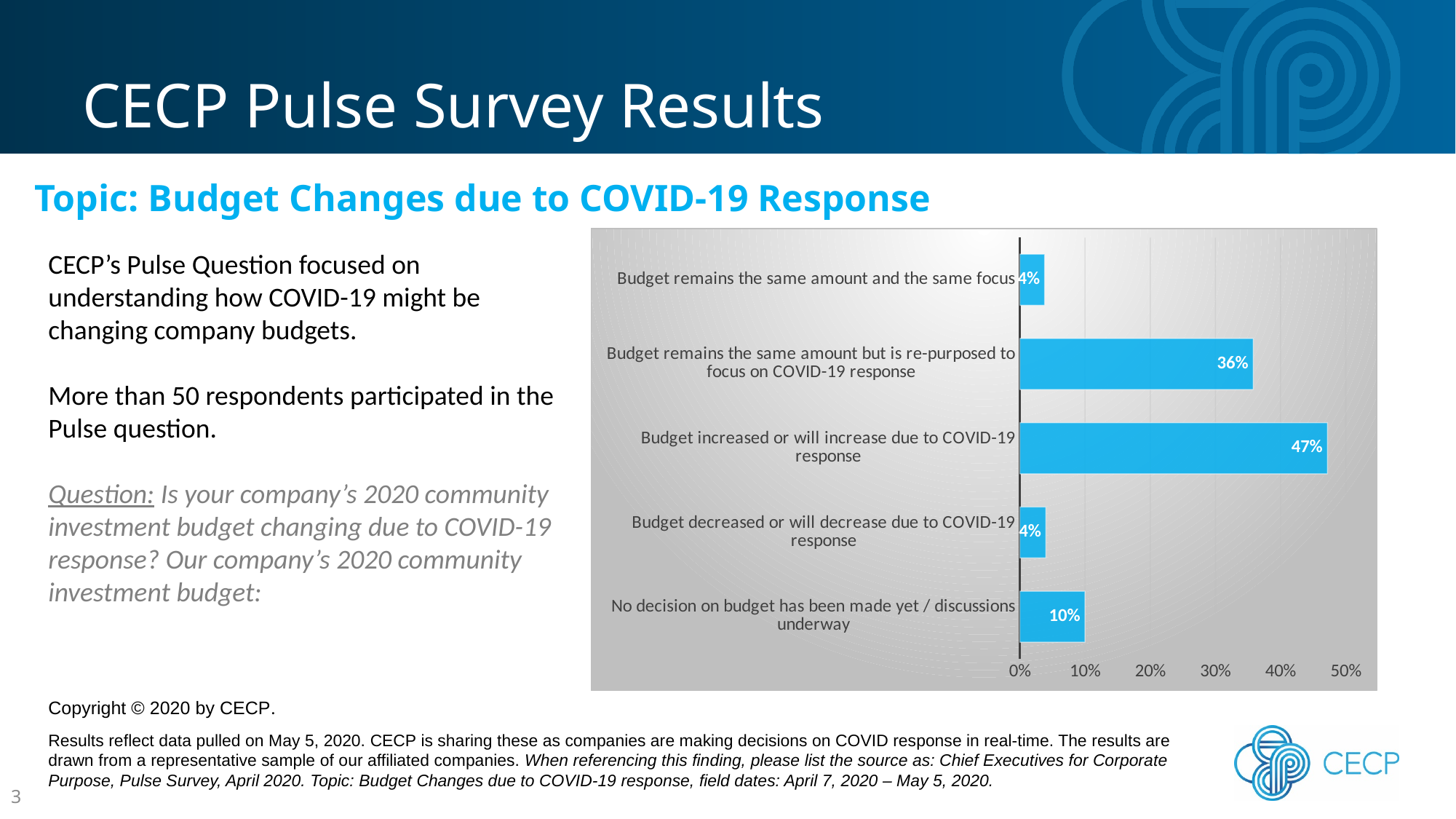
What percentage of respondents said no decision on budget has been made yet / discussions underway? 10% Which response category has the highest percentage? Budget increased or will increase due to COVID-19 response Is the value for 'Budget remains the same amount but is re-purposed to focus on COVID-19 response' greater or less than 30%? greater What kind of chart is shown on the slide? Bar chart What is the maximum value shown on the chart's horizontal axis? 50% How many response categories are shown in the chart? 5 What percentage of respondents said their budget remains the same amount but is re-purposed to focus on COVID-19 response? 36% What is the combined percentage of respondents whose budget remains the same amount (same focus plus re-purposed)? 40% Which is larger: the percentage for 'No decision on budget has been made yet / discussions underway' or for 'Budget decreased or will decrease due to COVID-19 response'? No decision on budget has been made yet / discussions underway What percentage of respondents said their budget increased or will increase due to COVID-19 response? 47% What is the difference in percentage points between 'Budget increased or will increase due to COVID-19 response' and 'Budget remains the same amount but is re-purposed to focus on COVID-19 response'? 11% What percentage of respondents said their budget decreased or will decrease due to COVID-19 response? 4%